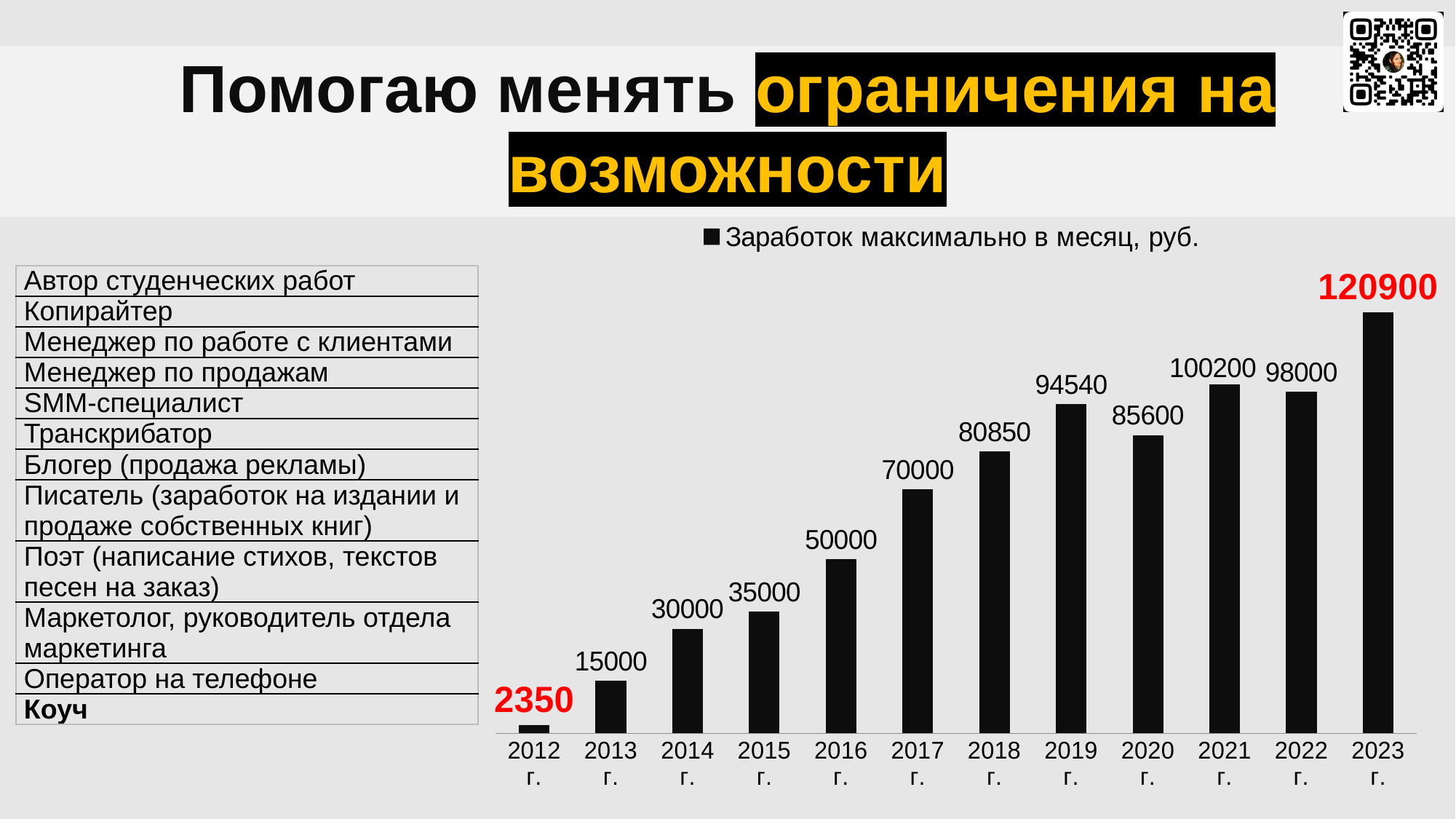
How many series does the legend list? 1 Which is larger, the value for 2021 г. or the value for 2022 г.? 2021 г. Which year has the highest value? 2023 г. What is the legend entry of the series? Заработок максимально в месяц, руб. What kind of chart is shown? bar chart How many years are shown on the x axis? 12 What is the value for 2019 г.? 94540 What is the value for 2012 г.? 2350 Which year has the lowest value? 2012 г. What is the difference between the values for 2018 г. and 2017 г.? 10850 What is the value for 2022 г.? 98000 What is the difference between the values for 2023 г. and 2022 г.? 22900